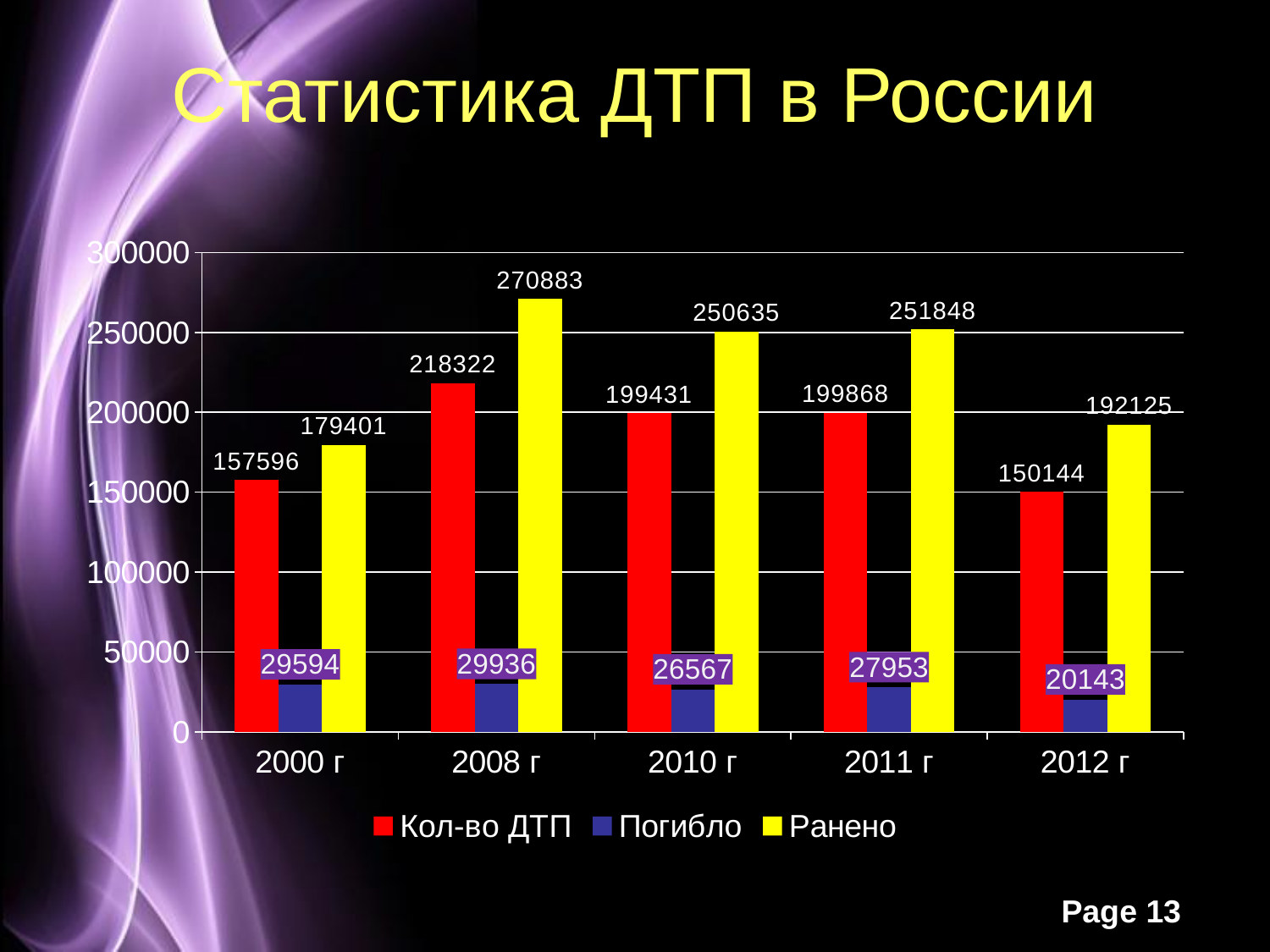
How many years are shown on the x axis? 5 What is the difference between Ранено in 2011 г and Ранено in 2010 г? 1213 In which year is Погибло the lowest? 2012 г What is the value of Кол-во ДТП for 2008 г? 218322 How many series does the legend list? 3 What is the value of Ранено for 2010 г? 250635 What type of chart is shown on the slide? bar chart What is the value of Погибло for 2012 г? 20143 In which year is Ранено the highest? 2008 г Is the value of Ранено for 2012 г greater or less than 200000? less Which is larger: Кол-во ДТП in 2000 г or Кол-во ДТП in 2012 г? 2000 г What is the title of the slide? Статистика ДТП в России